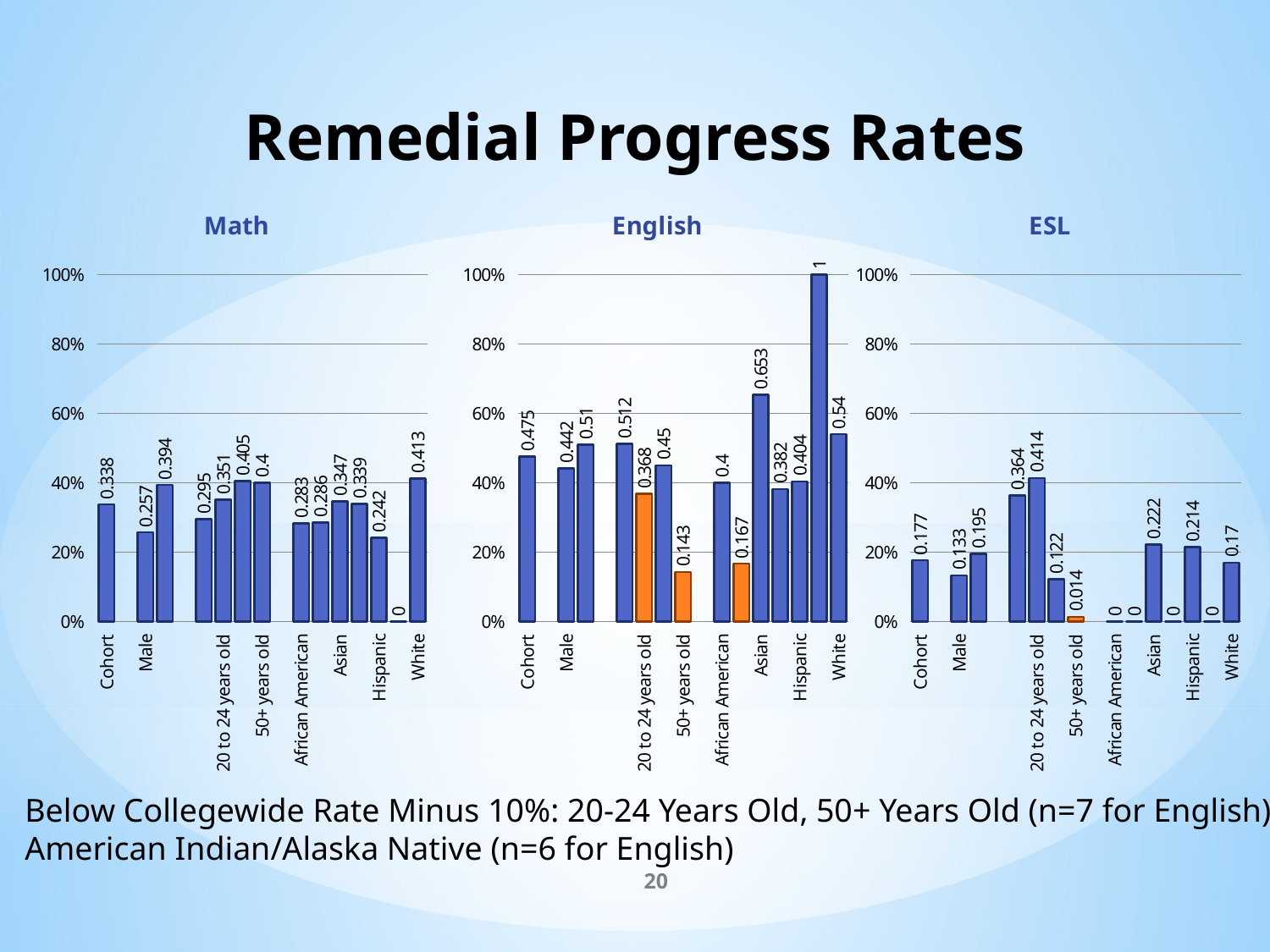
How many charts are shown on the slide? 3 On the English chart, what is the difference between the values for White and Hispanic? 0.136 On the Math chart, what is the value for Hispanic? 0.242 What kind of chart is the English chart? bar chart On the English chart, what is the value for Asian? 0.653 On the Math chart, what is the value for Cohort? 0.338 On the ESL chart, is the value for Cohort greater or less than 20%? less On the ESL chart, what is the value for Male? 0.133 On the ESL chart, what is the value for 50+ years old? 0.014 On the Math chart, which labeled category has the highest value? White On the Math chart, which is larger, the value for White or the value for Male? White On the ESL chart, which labeled category has the highest value? 20 to 24 years old